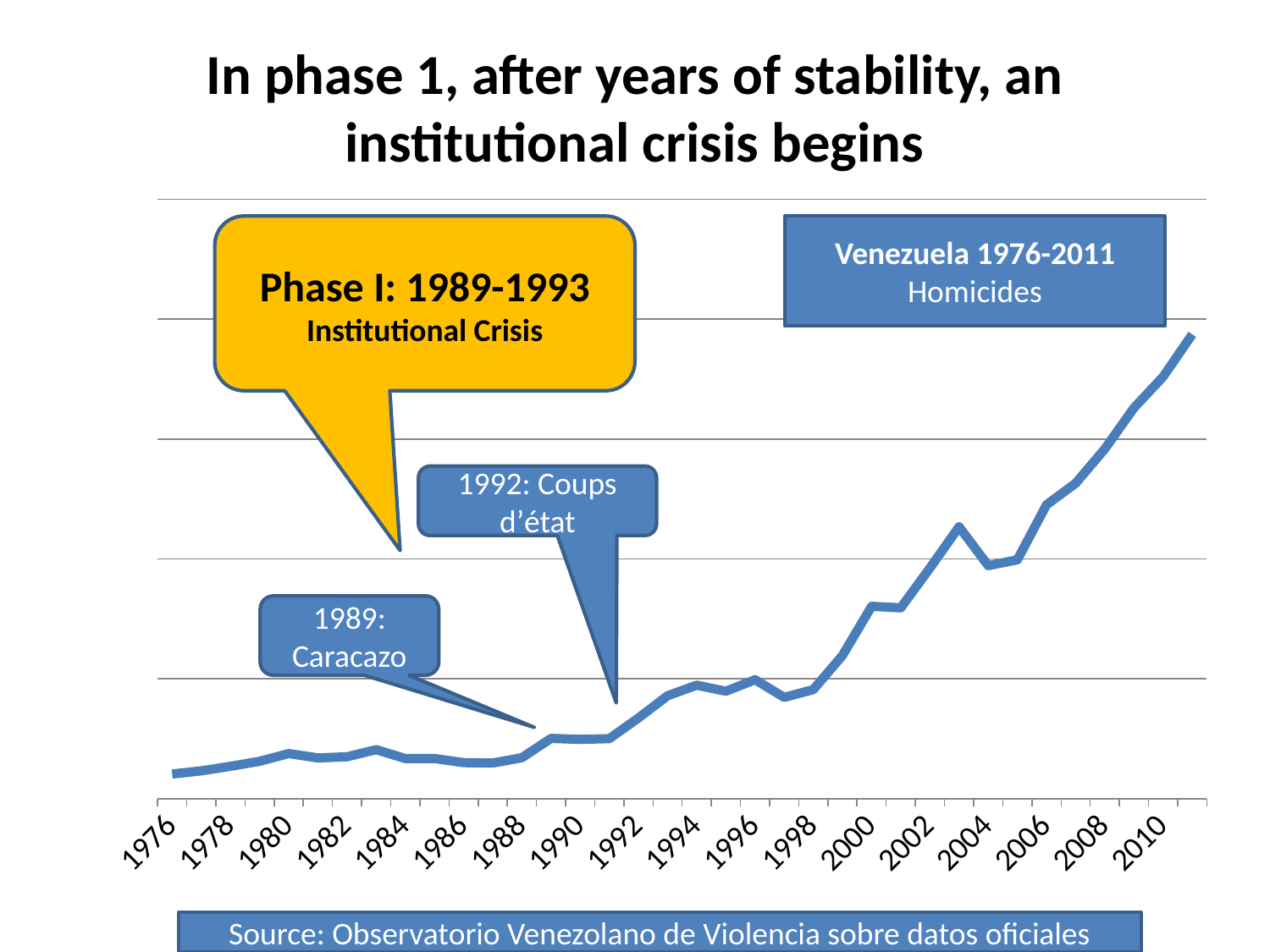
Between 1988 and 1989, does the homicide line rise or fall? Rise What is the title of the chart? Venezuela 1976-2011 Homicides What kind of chart is shown on the slide? Line chart What is the first year labelled on the x axis? 1976 Which year has the higher value on the line, 1999 or 2009? 2009 In which year does the homicide line reach its highest point? 2011 Which year has the higher value on the line, 2003 or 2004? 2003 Overall, do homicides rise or fall from 1976 to 2011? Rise What event does the callout pointing to 1989 on the chart name? Caracazo Which year has the higher value on the line, 1988 or 1994? 1994 Between 2003 and 2004, does the homicide line rise or fall? Fall In which year is the homicide line at its lowest point? 1976